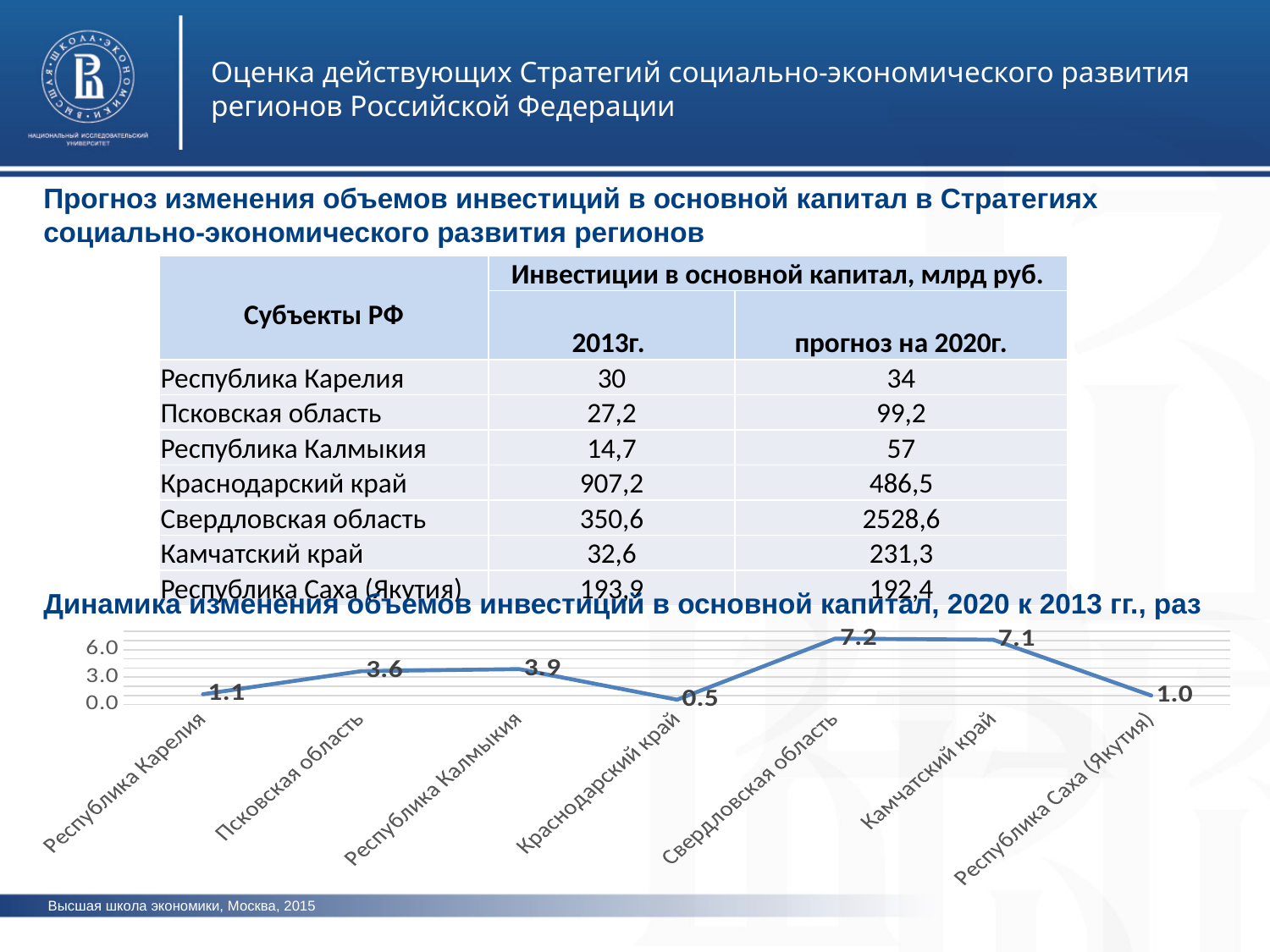
What is the value for Республика Калмыкия on the line chart? 3.9 What is the title of the line chart? Динамика изменения объемов инвестиций в основной капитал, 2020 к 2013 гг., раз Which is larger on the line chart: the value for Псковская область or the value for Республика Калмыкия? Республика Калмыкия What is the value for Краснодарский край on the line chart? 0.5 What is the value for Республика Саха (Якутия) on the line chart? 1.0 Which region has the lowest value on the line chart? Краснодарский край Which region has the highest value on the line chart? Свердловская область What type of chart is shown on the slide? line chart How many regions are plotted on the line chart? 7 What is the difference between the values for Камчатский край and Республика Карелия on the line chart? 6.0 Is the value for Камчатский край on the line chart greater or less than 6.0? greater What is the value for Свердловская область on the line chart? 7.2